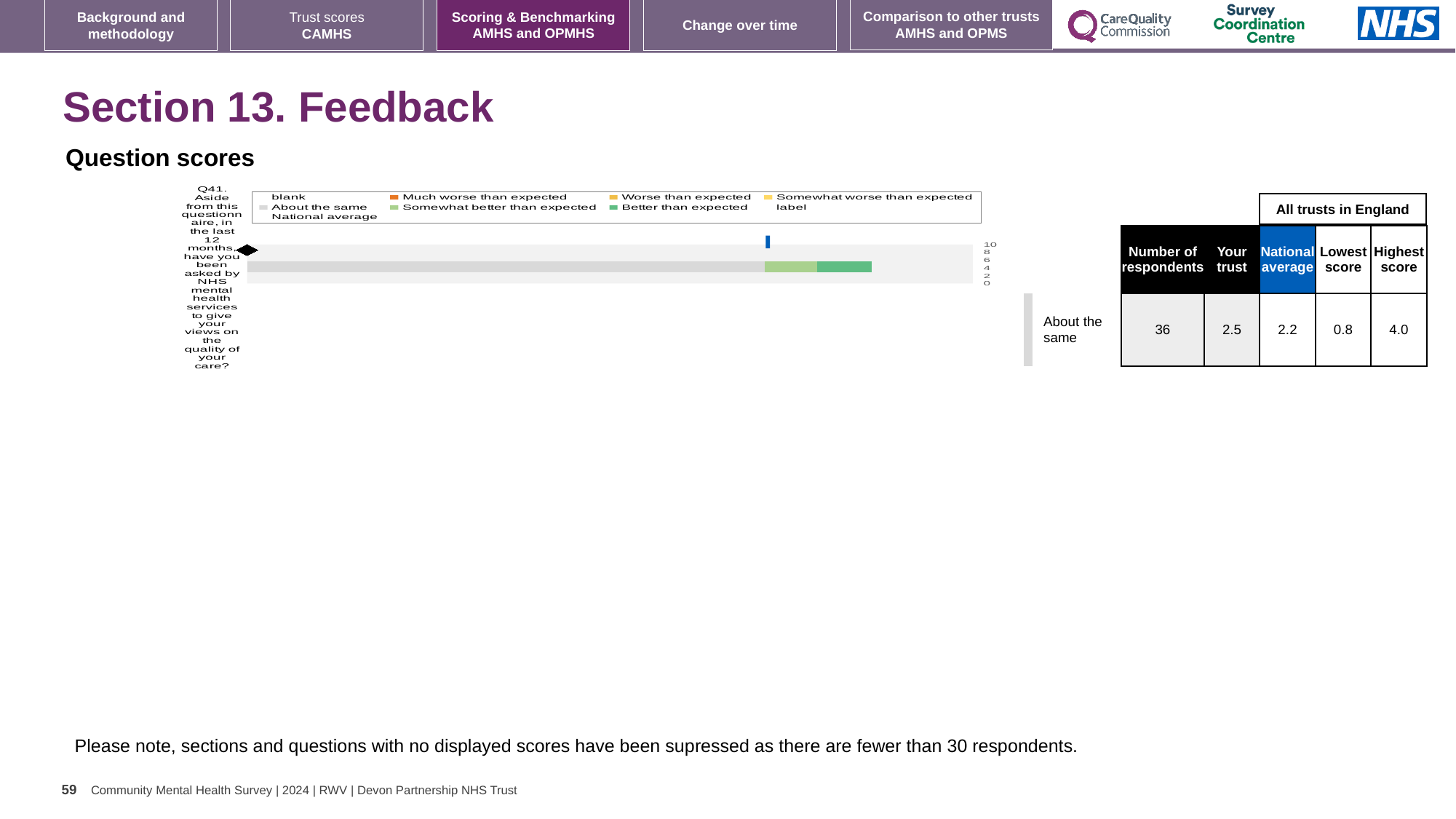
What kind of chart is used to show the Q41 question score? bar chart What is the highest tick value shown on the axis of the Q41 chart? 10 How many entries does the legend of the Q41 chart list? 9 In the table beside the Q41 chart, what is the 'Your trust' score? 2.5 In the table beside the Q41 chart, what is the highest score among all trusts in England? 4.0 For Q41, which is larger: the 'Your trust' score or the national average? Your trust For Q41, what is the difference between the highest score and the lowest score among all trusts in England? 3.2 In the table beside the Q41 chart, what is the national average score? 2.2 In the table beside the Q41 chart, what is the number of respondents? 36 Which colour in the Q41 chart legend represents 'Better than expected'? green How many questions are plotted in the Q41 chart? 1 In the table beside the Q41 chart, what is the lowest score among all trusts in England? 0.8